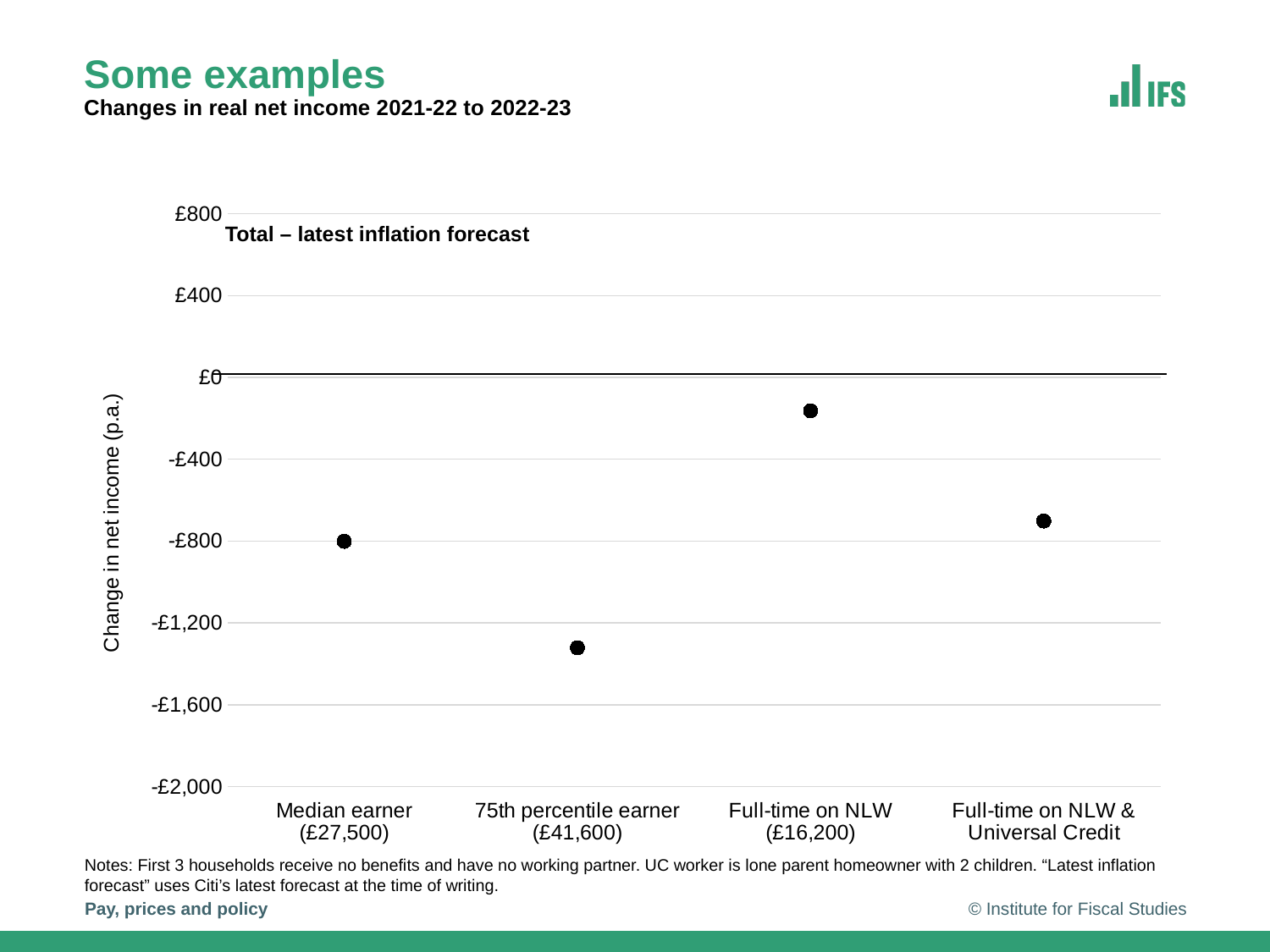
Which category has the lowest change in net income? 75th percentile earner (£41,600) What is the label on the y axis of the chart? Change in net income (p.a.) Which category has the highest (least negative) change in net income? Full-time on NLW (£16,200) What is the label shown inside the chart area above the plotted points? Total – latest inflation forecast Is the value for the 75th percentile earner (£41,600) greater or less than -£1,200? less Is the value for Full-time on NLW (£16,200) greater or less than -£400? greater Is the value for Full-time on NLW & Universal Credit greater or less than -£800? greater Which has a lower change in net income, the Median earner or the 75th percentile earner? 75th percentile earner What is the change in net income for the Median earner (£27,500)? -£800 What kind of chart is shown on the slide? Scatter (dot) chart How many household categories are plotted on the x axis? 4